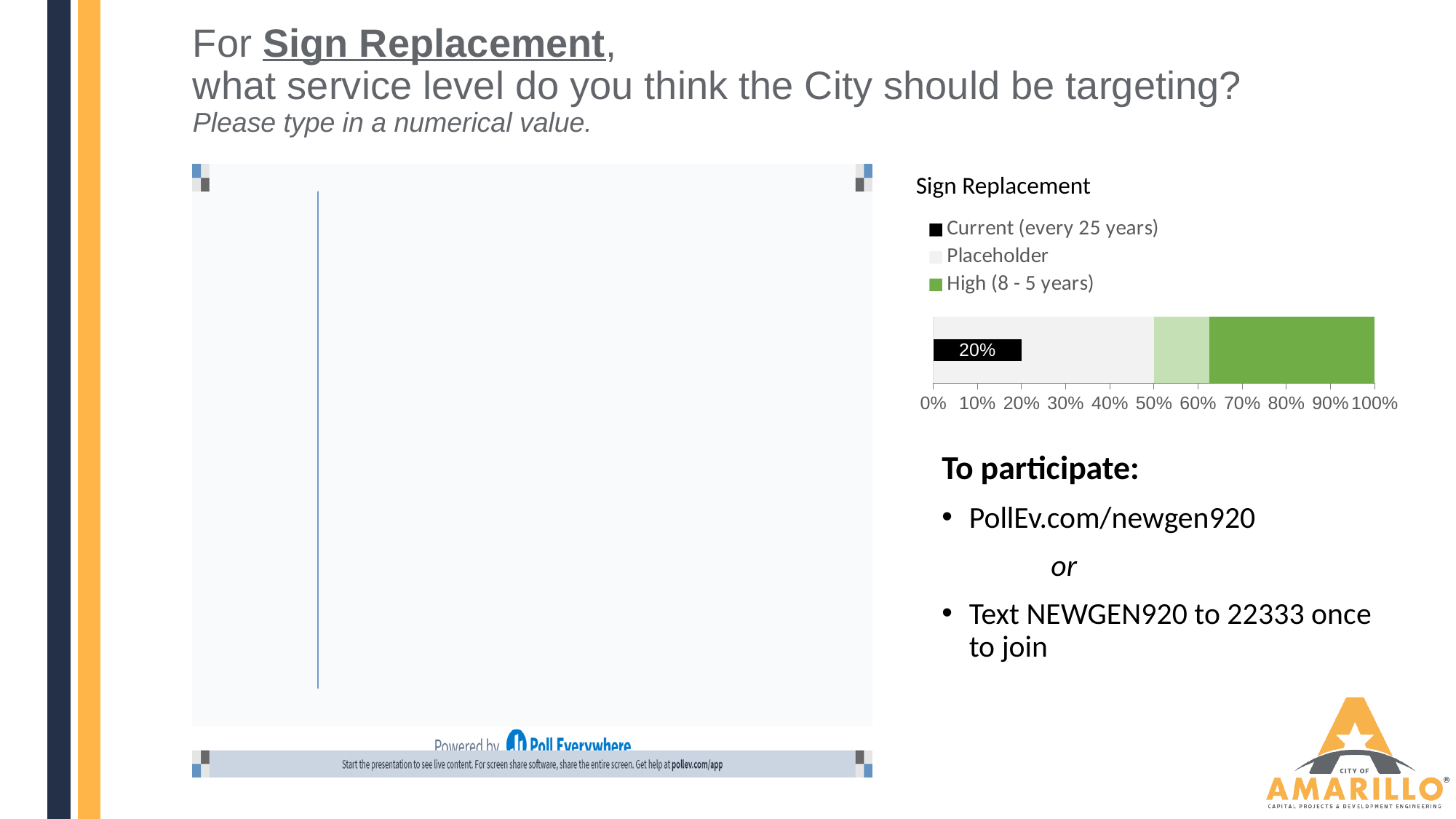
According to the legend of the Sign Replacement chart, how often is the Current replacement interval? Every 25 years In the Sign Replacement chart, is the value for Current (every 25 years) greater or less than 10%? greater What colour represents the High (8 - 5 years) series in the Sign Replacement chart? Green How many series does the legend of the Sign Replacement chart list? 3 In the Sign Replacement chart, what value is printed on the black bar for Current (every 25 years)? 20% In the Sign Replacement chart, is the value for Current (every 25 years) greater or less than 50%? less What is the title of the chart on the right side of the slide? Sign Replacement What kind of chart is shown under the title "Sign Replacement"? Bar chart What is the highest value shown on the x axis of the Sign Replacement chart? 100%